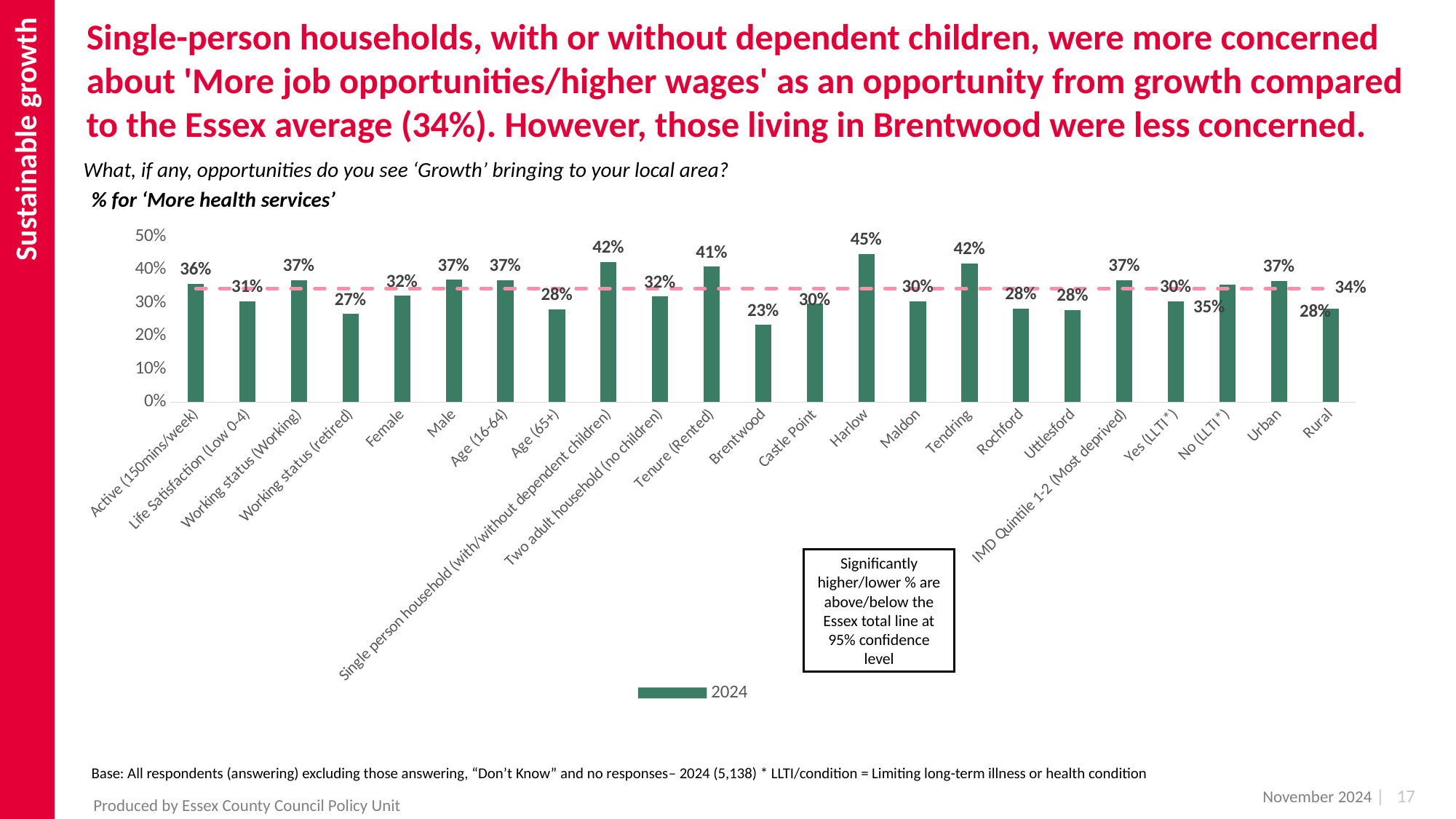
What is the value for Harlow? 45% What is the value for Single person household (with/without dependent children)? 42% What is the value for Brentwood? 23% Which category has the lowest value? Brentwood Which category has the highest value? Harlow Which is larger, the value for Female or the value for Male? Male What kind of chart is this? bar chart What is the value for Tenure (Rented)? 41% What value does the dashed horizontal line represent? 34% Is the value for Working status (retired) greater or less than 30%? less What is the difference between the values for Harlow and Brentwood? 22% How many categories are shown on the x axis? 23